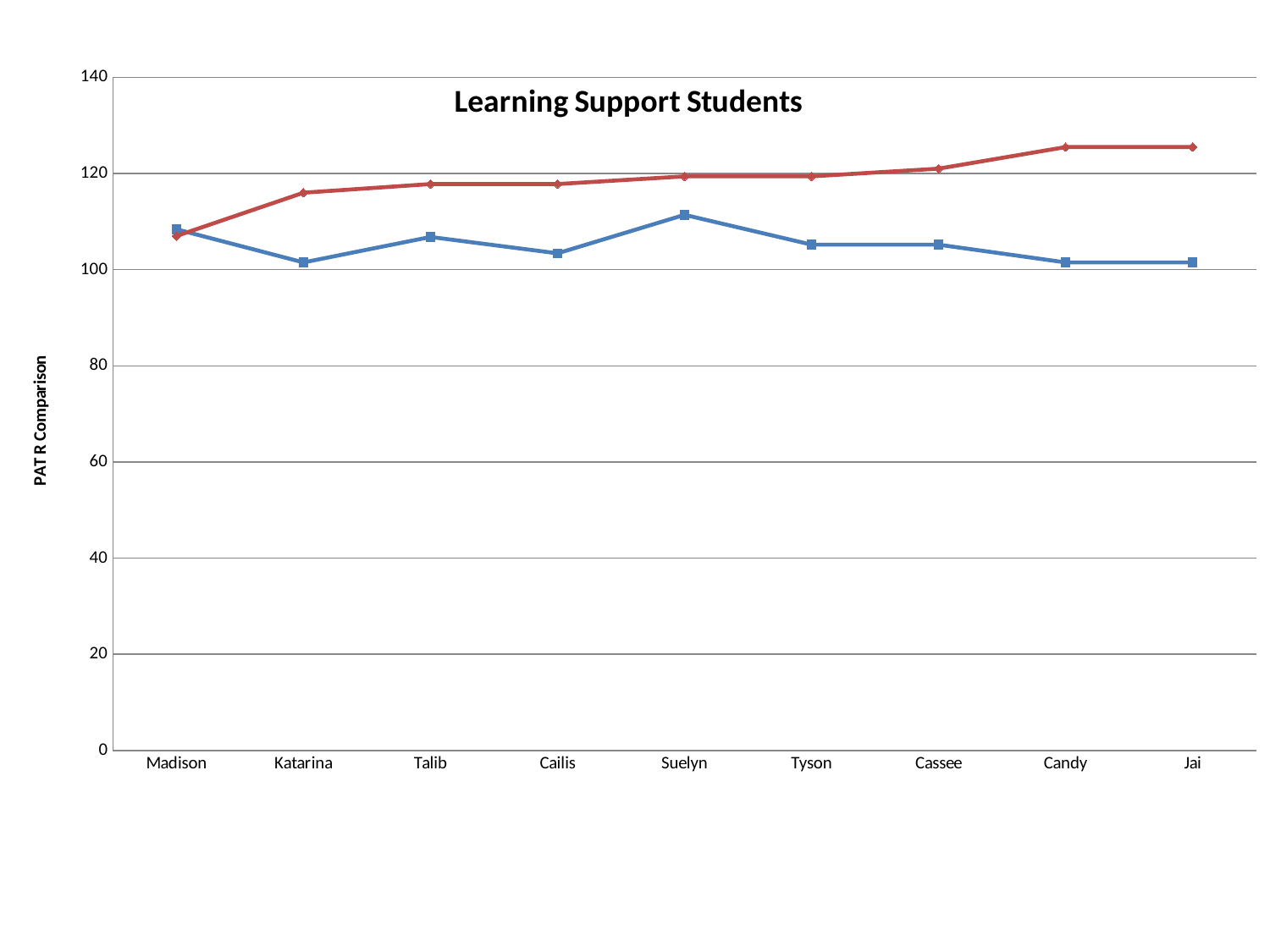
How many lines are plotted on the chart? 2 Is the value of the blue line for Suelyn greater or less than 100? greater Is the value of the blue line for Tyson greater or less than 120? less What is the label on the vertical axis of the chart? PAT R Comparison For which student does the red line have its lowest value? Madison What kind of chart is shown on the slide? line chart Is the value of the red line for Madison greater or less than 120? less At Suelyn, which line has the higher value, the red line or the blue line? the red line How many students are listed along the x axis of the chart? 9 What is the title of the chart? Learning Support Students For which student does the blue line reach its highest value? Suelyn